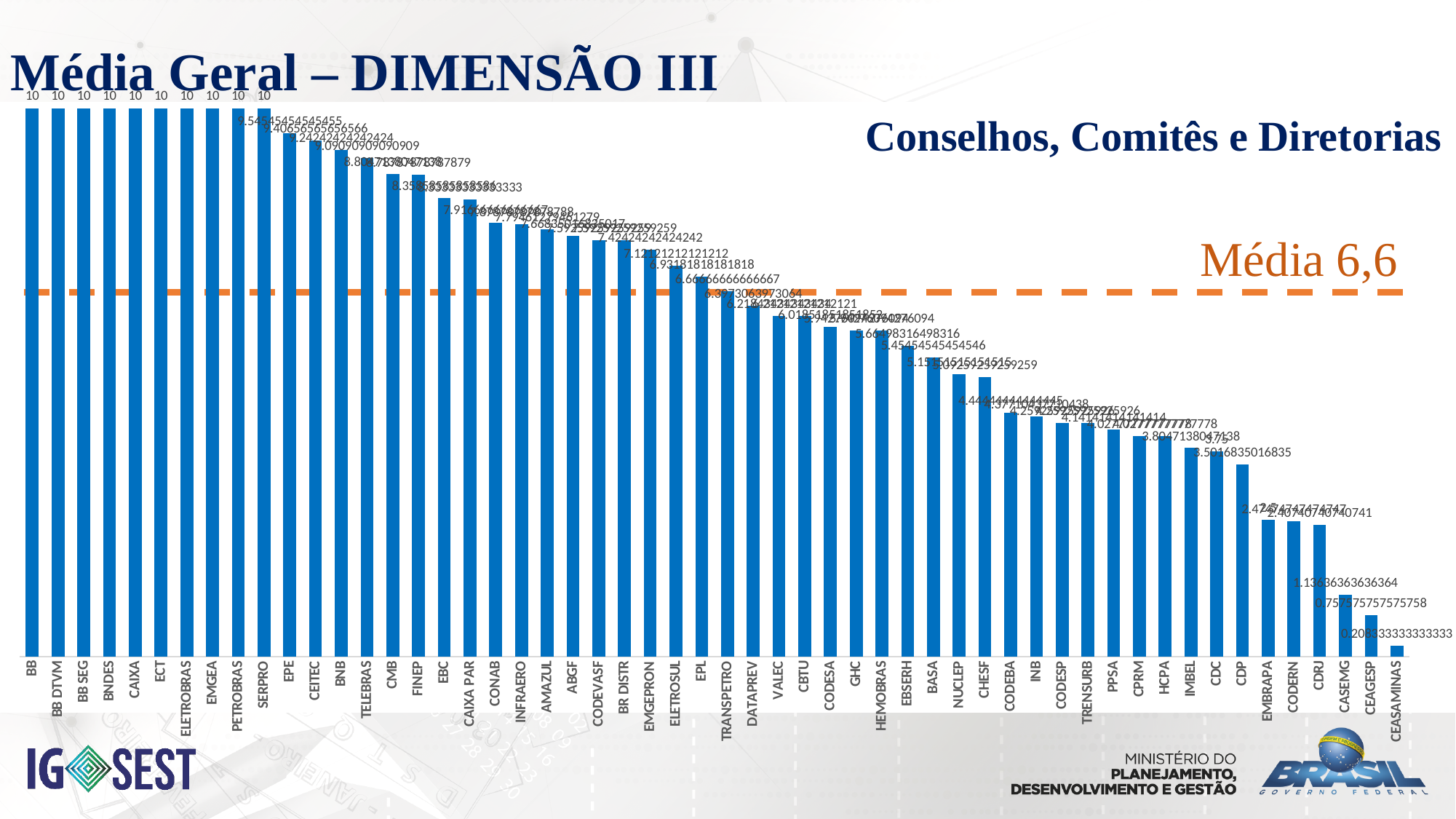
What kind of chart is shown on the slide? bar chart Which has the larger value, BNDES or CDP? BNDES What is the value for TELEBRAS? 9.09090909090909 Is the value for CPRM greater or less than 5? less What is the value for CEASAMINAS? 0.208333333333333 What is the value for CEAGESP? 0.757575757575758 Which category has the lowest value? CEASAMINAS What is the value for BB? 10 What is the value for EPE? 9.54545454545455 What average value does the dashed orange line represent? 6,6 Do the values rise or fall from left to right along the x axis? fall How many categories have a value of 10? 10